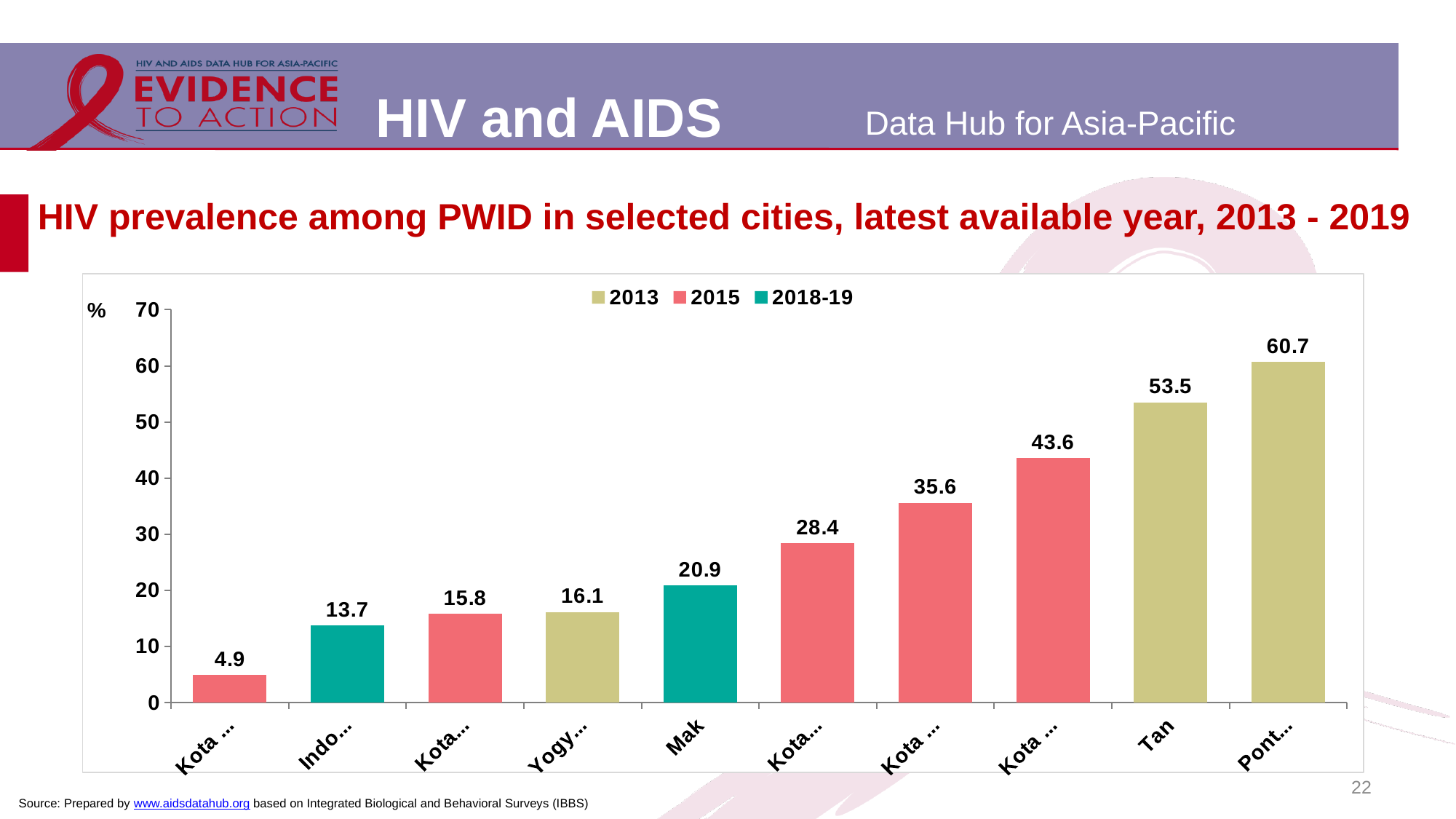
What are the three entries in the chart legend? 2013, 2015, 2018-19 How many bars are plotted on the chart? 10 What is the value of the bar labelled "Mak"? 20.9 Do the bar values rise or fall from left to right along the x axis? rise How many series does the legend list? 3 What is the value of the bar labelled "Tan"? 53.5 What is the highest value shown on the chart? 60.7 Which series has more bars on the chart, 2013 or 2015? 2015 What is the difference between the two 2018-19 bars (20.9 and 13.7)? 7.2 What is the difference between the highest and lowest values on the chart? 55.8 What kind of chart is shown on the slide? bar chart What is the lowest value shown on the chart? 4.9